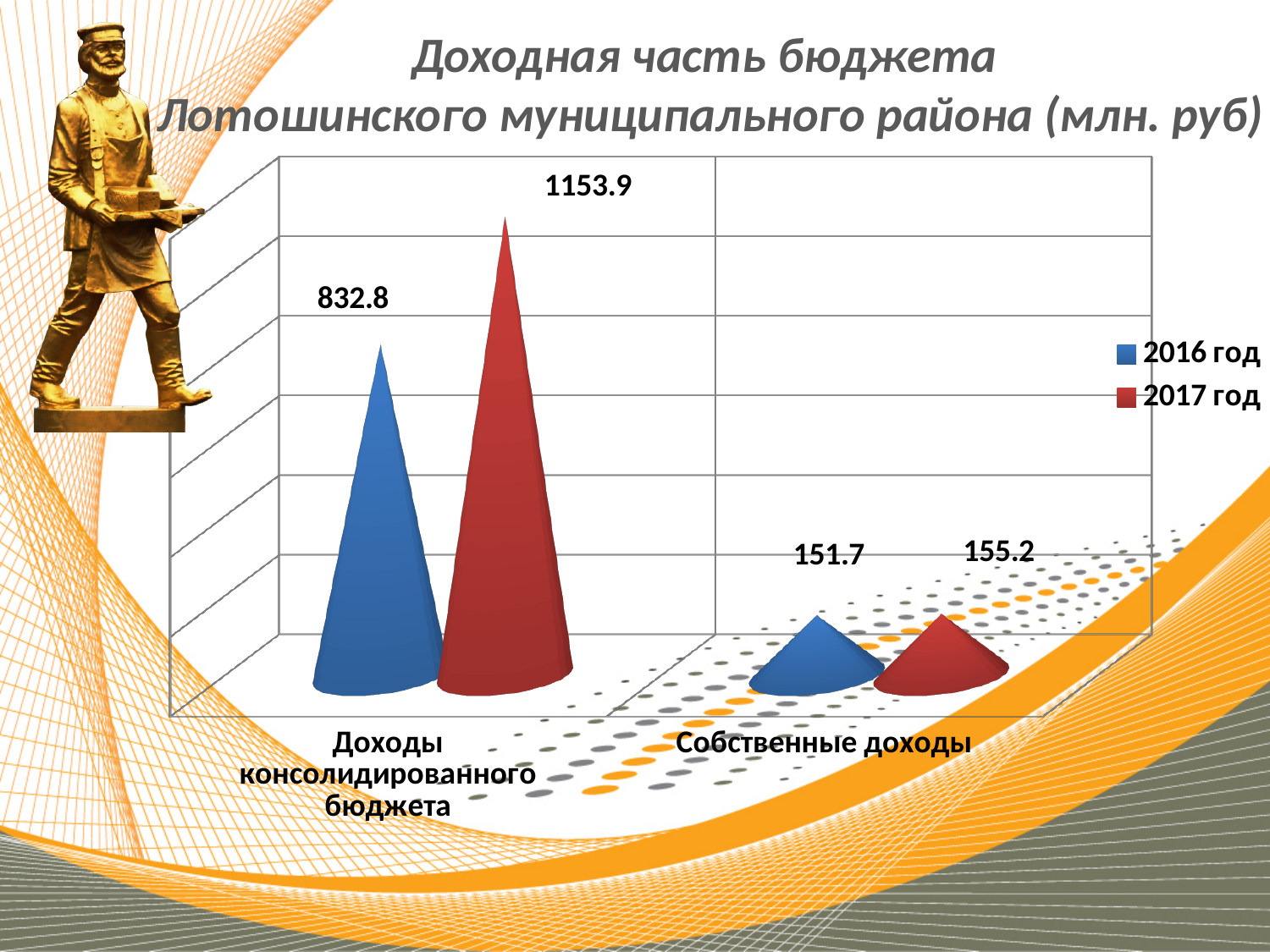
Which is larger: the 2016 год value for Доходы консолидированного бюджета or the 2017 год value for Собственные доходы? 2016 год value for Доходы консолидированного бюджета What is the difference between the 2017 год and 2016 год values for Собственные доходы? 3.5 What kind of chart is shown on the slide? Bar chart How many series does the legend list? 2 What is the value for 2016 год in the category Собственные доходы? 151.7 What is the value for 2016 год in the category Доходы консолидированного бюджета? 832.8 How many categories are shown on the x axis of the chart? 2 What is the difference between the 2017 год and 2016 год values for Доходы консолидированного бюджета? 321.1 Which series has the highest value in the category Доходы консолидированного бюджета? 2017 год Which category has the lowest value for 2016 год? Собственные доходы What is the value for 2017 год in the category Собственные доходы? 155.2 What is the value for 2017 год in the category Доходы консолидированного бюджета? 1153.9